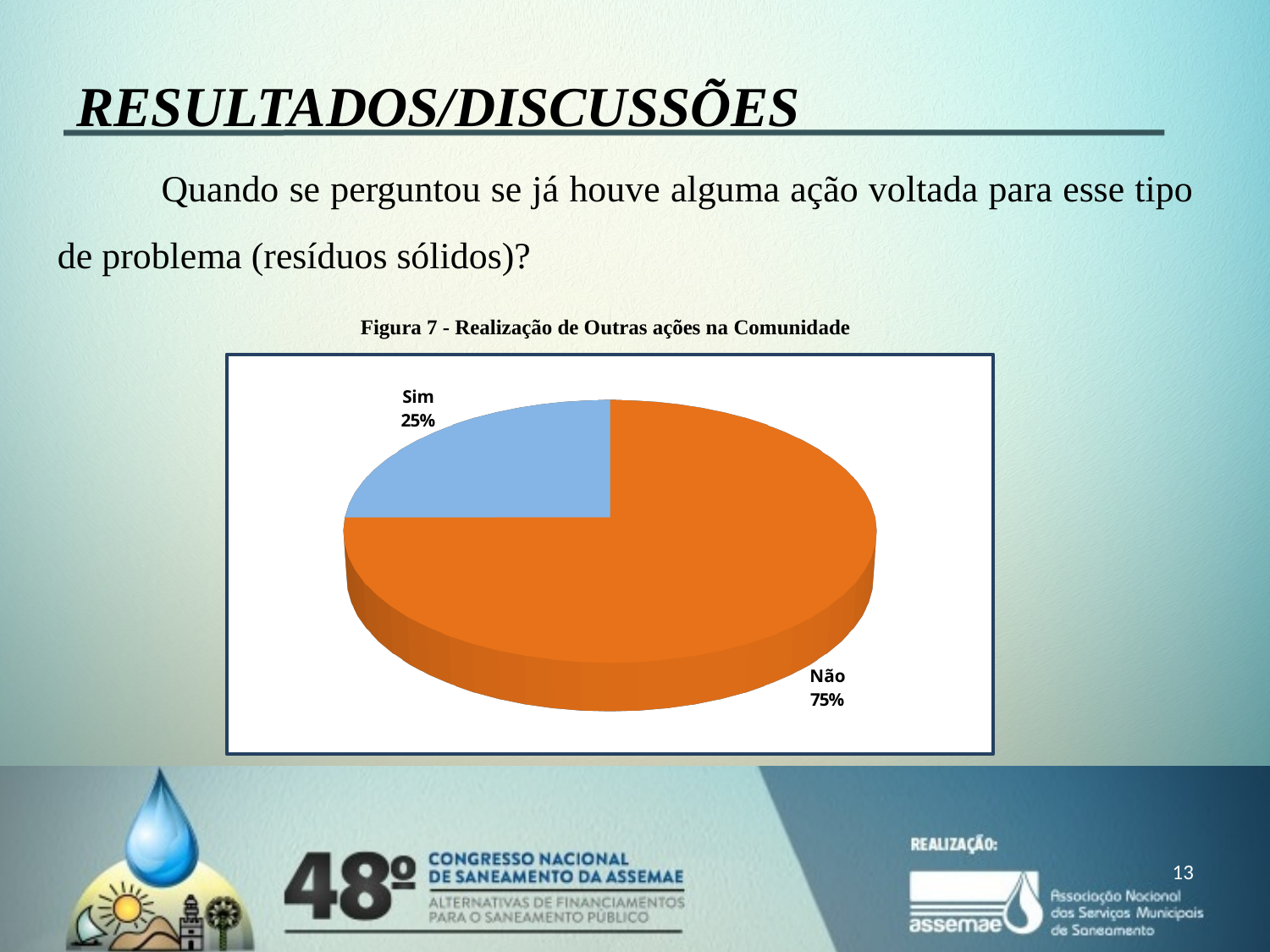
What is the difference in percentage points between the "Não" and "Sim" slices? 50 What kind of chart is shown on the slide? Pie chart What share of the pie does the "Sim" slice represent? 25% Is the value for "Sim" greater or less than 50%? less What is the title of the figure shown on the slide? Figura 7 - Realização de Outras ações na Comunidade What share of the pie does the "Não" slice represent? 75% Which slice is the largest in the pie chart? Não Which slice is the smallest in the pie chart? Sim What is the total of the two slices shown in the pie chart? 100% What colour is the "Não" slice of the pie chart? Orange Which is larger, the "Sim" slice or the "Não" slice? Não How many slices does the pie chart have? 2